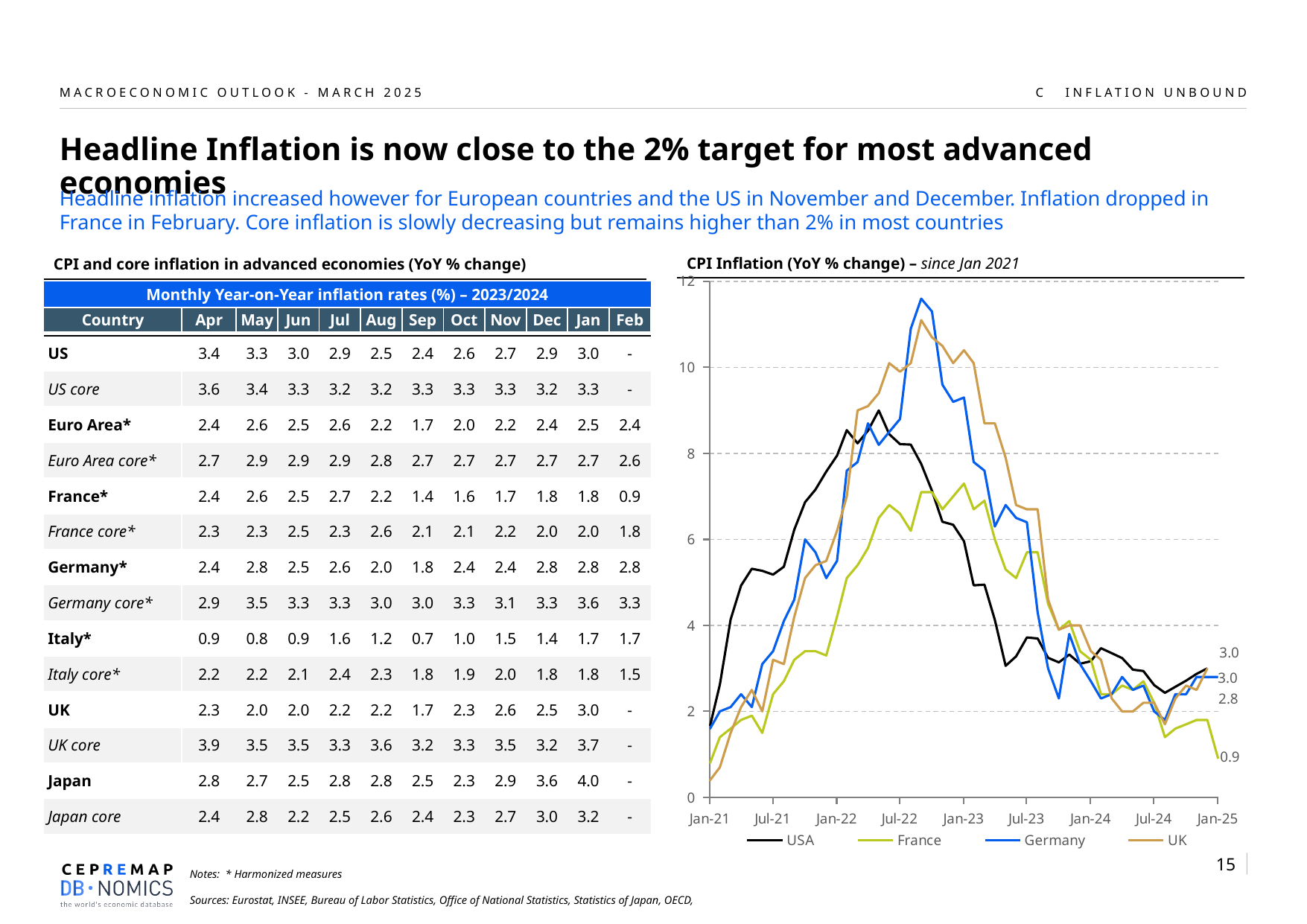
In the CPI Inflation chart, is the value for USA at Jul-22 greater or less than 8? greater What kind of chart is the 'CPI Inflation (YoY % change) – since Jan 2021' chart? line chart In the CPI Inflation chart, is the final value for France greater or less than the final value for Germany? less In the CPI Inflation chart, which series has the lowest value at the end of the period? France In the CPI Inflation chart, what is the final labelled value for France? 0.9 How many series does the legend of the CPI Inflation chart list? 4 In the CPI Inflation chart, what is the final labelled value for Germany? 2.8 In the CPI Inflation chart, which series reaches the highest peak? Germany In the CPI Inflation chart, is the peak value for France greater or less than 8? less In the CPI Inflation chart, do the values generally rise or fall between Jan-23 and Jan-25? fall Which countries are listed in the legend of the CPI Inflation chart? USA, France, Germany, UK In the CPI Inflation chart, what is the first date shown on the x axis? Jan-21